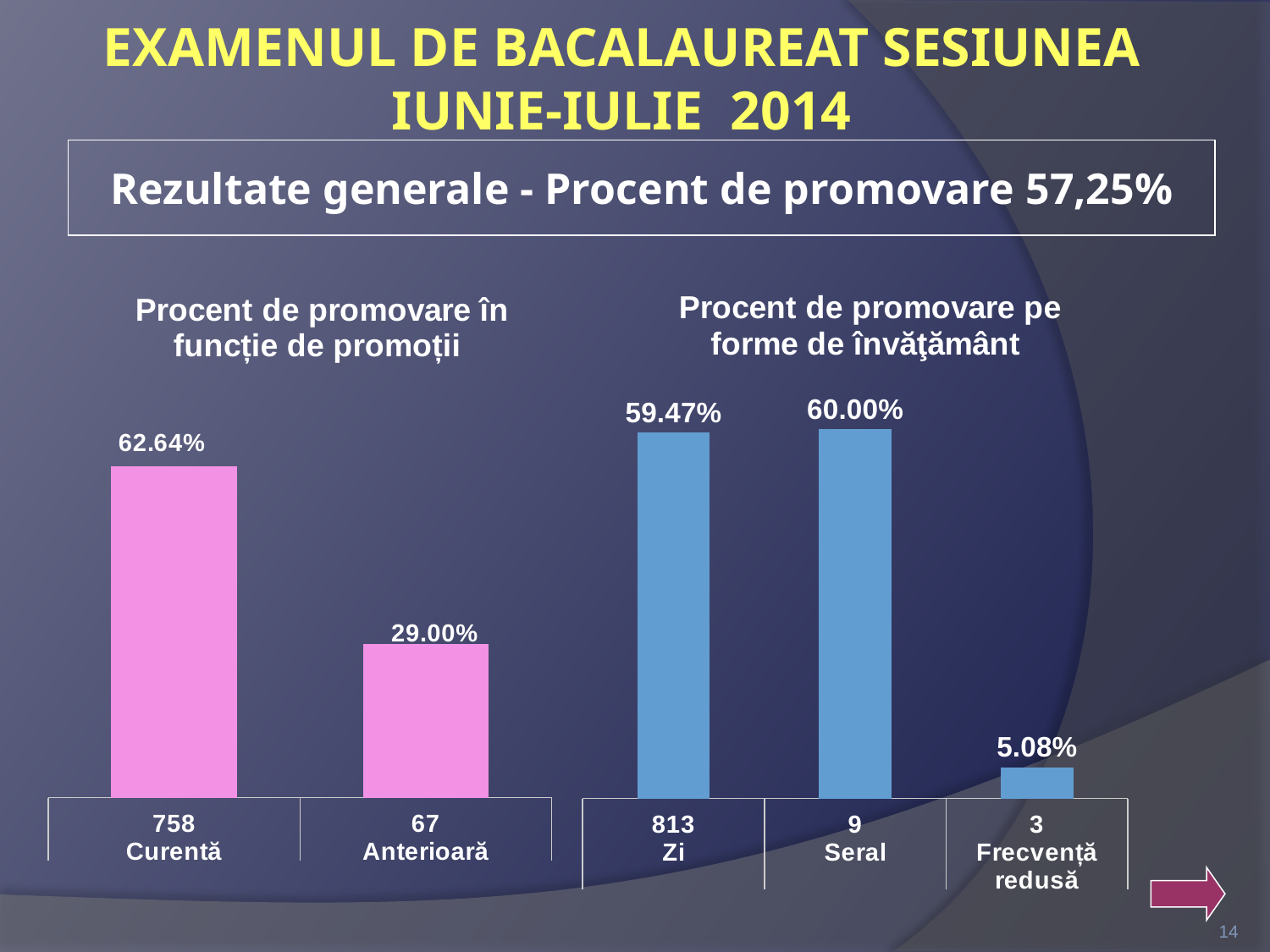
In the chart 'Procent de promovare în funcție de promoții', how many categories are shown? 2 What kind of chart is 'Procent de promovare în funcție de promoții'? Bar chart In the chart 'Procent de promovare pe forme de învăţământ', which category has the highest value? Seral In the chart 'Procent de promovare pe forme de învăţământ', how many categories are shown? 3 In the chart 'Procent de promovare în funcție de promoții', what is the value for Anterioară? 29.00% In the chart 'Procent de promovare în funcție de promoții', what is the value for Curentă? 62.64% In the chart 'Procent de promovare pe forme de învăţământ', which category has the lowest value? Frecvență redusă In the chart 'Procent de promovare pe forme de învăţământ', what is the value for Seral? 60.00% In the chart 'Procent de promovare pe forme de învăţământ', what number is shown under the Zi category label? 813 In the chart 'Procent de promovare în funcție de promoții', what is the difference between the Curentă and Anterioară values? 33.64% In the chart 'Procent de promovare pe forme de învăţământ', what is the value for Zi? 59.47% In the chart 'Procent de promovare pe forme de învăţământ', what is the value for Frecvență redusă? 5.08%